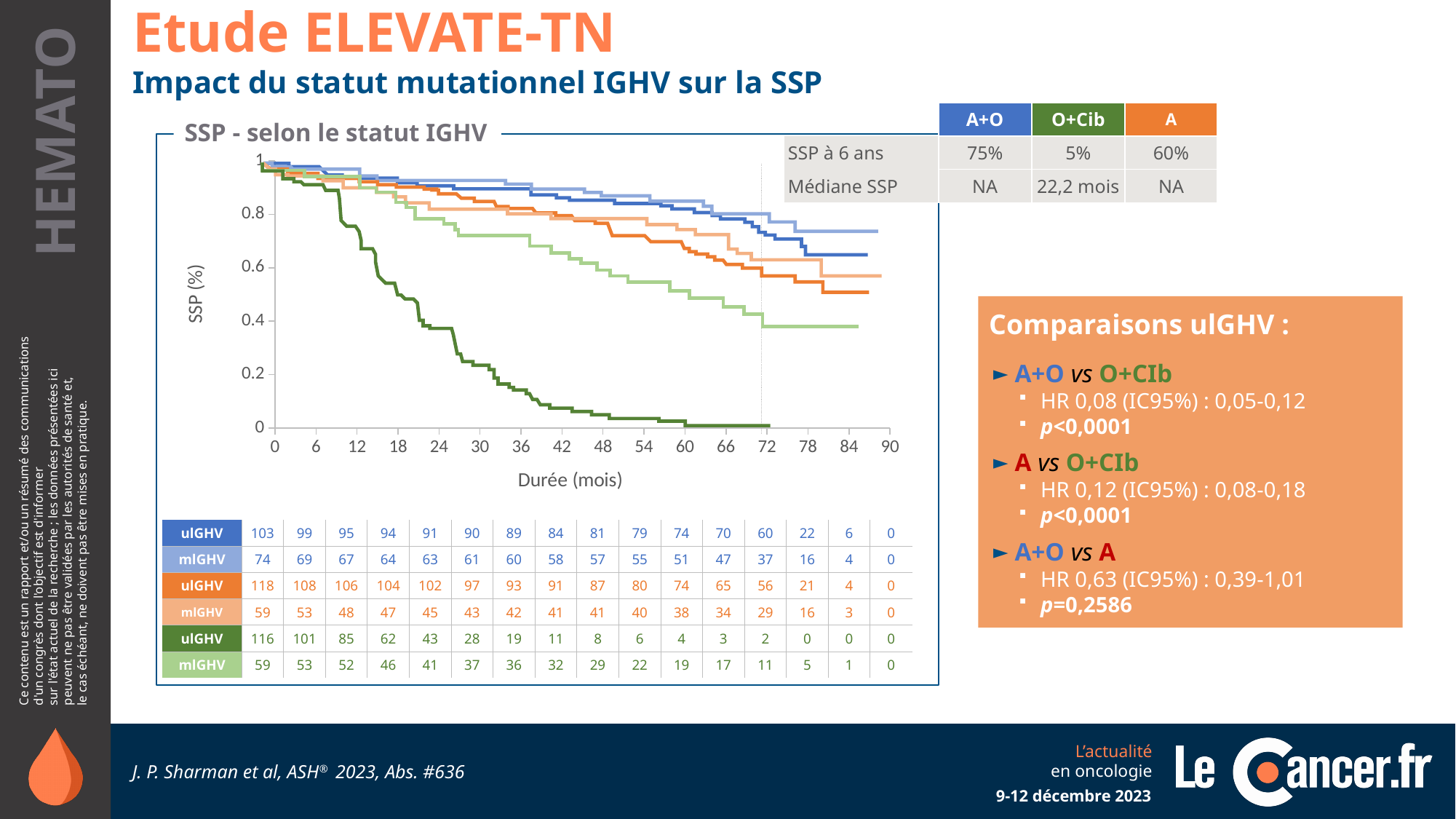
On the "SSP - selon le statut IGHV" chart, which curve is highest at 84 months? light blue mIGHV How many curves are plotted on the "SSP - selon le statut IGHV" chart? 6 In the number-at-risk table under the "SSP - selon le statut IGHV" chart, what is the difference between the dark blue uIGHV row and the light blue mIGHV row at 0 months? 29 On the "SSP - selon le statut IGHV" chart, which curve is lowest at 72 months? dark green uIGHV What is the x-axis title of the "SSP - selon le statut IGHV" chart? Durée (mois) On the "SSP - selon le statut IGHV" chart, is the value of the dark green uIGHV curve at 48 months greater or less than 0.2? less On the "SSP - selon le statut IGHV" chart, do the curves rise or fall as Durée (mois) increases? fall On the "SSP - selon le statut IGHV" chart, is the value of the dark blue uIGHV curve at 60 months greater or less than 0.6? greater In the number-at-risk table under the "SSP - selon le statut IGHV" chart, how many patients are at risk in the dark blue uIGHV row at 0 months? 103 On the "SSP - selon le statut IGHV" chart, at 48 months is the light green mIGHV curve higher or lower than the dark orange uIGHV curve? lower What kind of chart is "SSP - selon le statut IGHV"? line chart What is the y-axis title of the "SSP - selon le statut IGHV" chart? SSP (%)